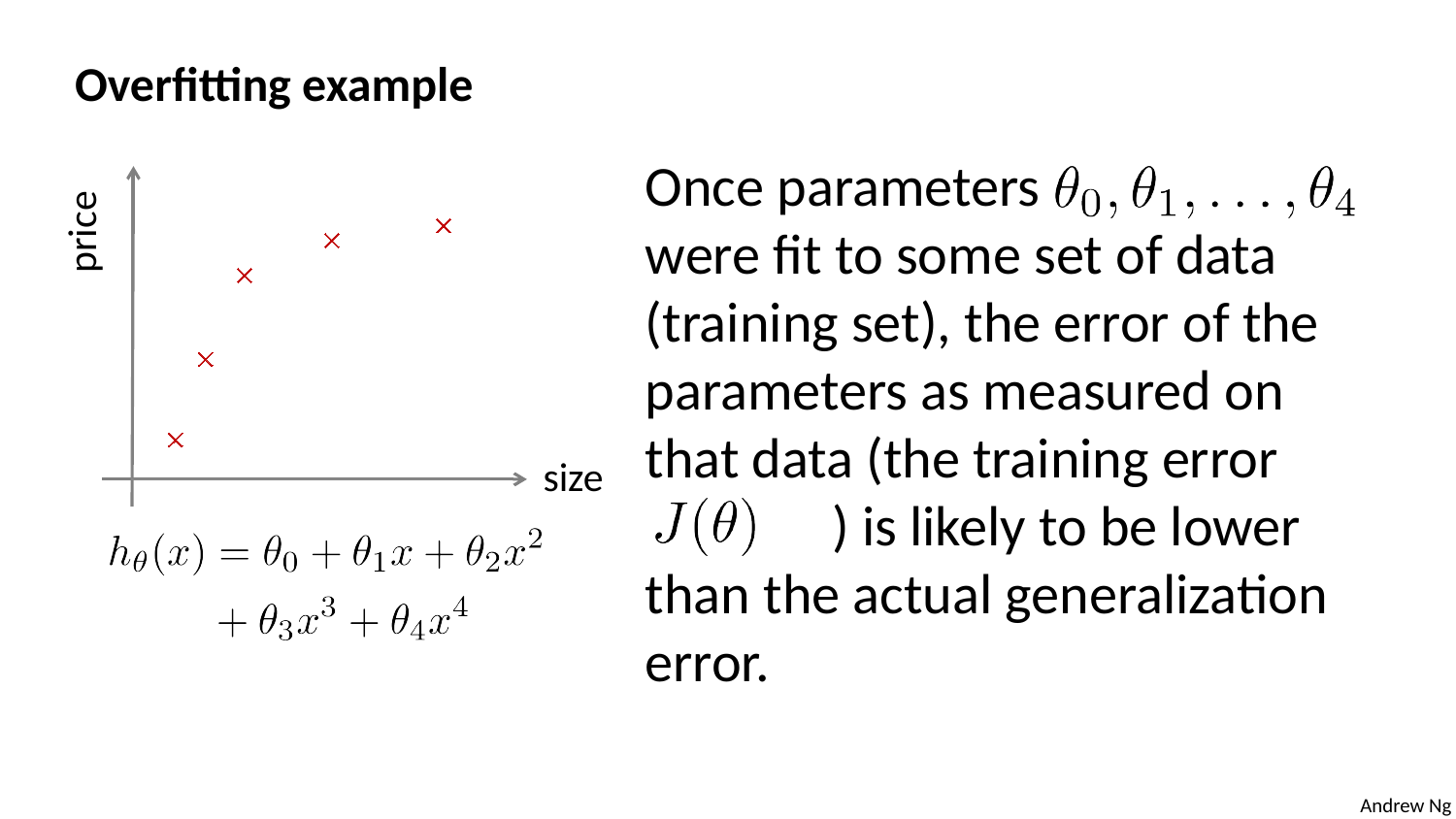
How many data points are plotted on the chart? 5 Do the plotted values rise or fall as size increases along the x axis? rise Which plotted point has the lowest price, the leftmost or the rightmost? the leftmost What is the label of the horizontal axis of the chart? size What kind of chart is shown on the slide? scatter plot Is the price of the second point from the left larger or smaller than the price of the fourth point from the left? smaller Which plotted point has the highest price, the leftmost or the rightmost? the rightmost What is the label of the vertical axis of the chart? price